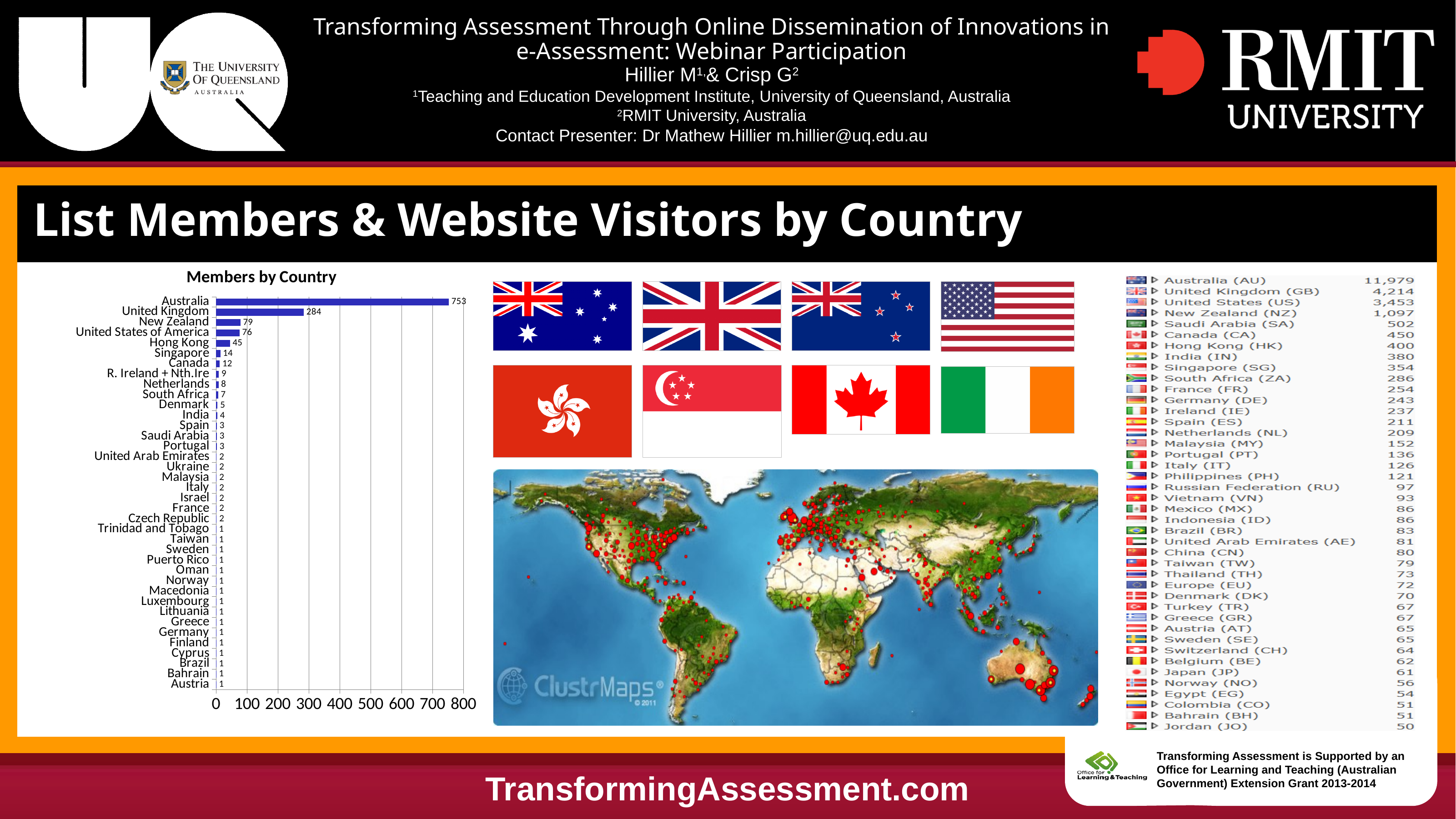
What is the difference between the values for New Zealand and Canada in the chart? 67 Which country has the highest number of members in the chart? Australia What kind of chart is the Members by Country chart? bar chart What is the value for Australia in the Members by Country chart? 753 What is the difference between the values for Australia and the United Kingdom? 469 How many members does the United Kingdom have according to the chart? 284 What is the title of the chart on the left of the slide? Members by Country Which has a larger value in the chart, New Zealand or United States of America? New Zealand What is the value for Singapore in the Members by Country chart? 14 How many countries are listed in the Members by Country chart? 38 What is the value shown for Hong Kong in the Members by Country chart? 45 Is the value for the United Kingdom greater or less than 200? greater